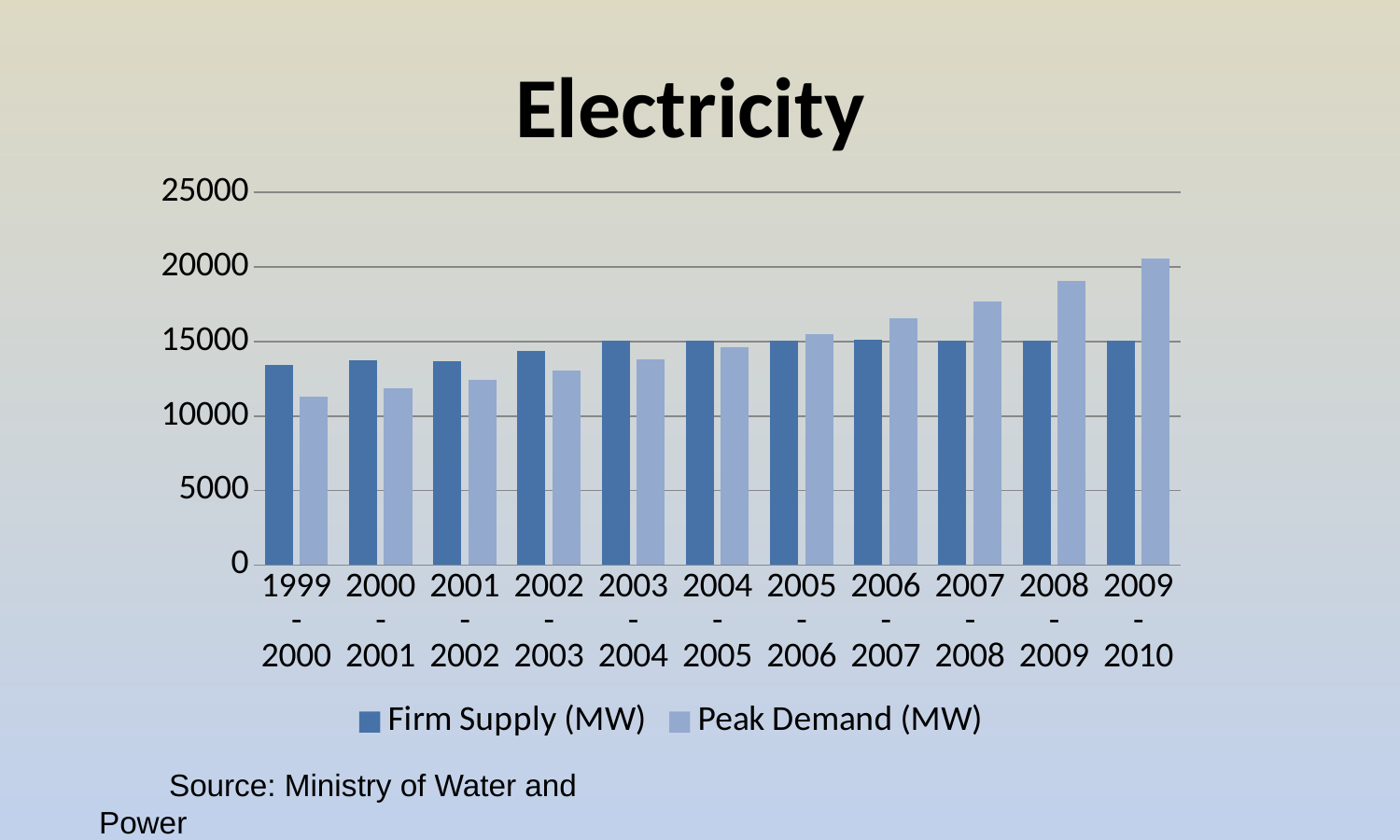
In 2009-2010, which is larger: Firm Supply (MW) or Peak Demand (MW)? Peak Demand (MW) How many series does the legend list? 2 Does Peak Demand (MW) generally rise or fall from 1999-2000 to 2009-2010? rise What is the title of the chart? Electricity Is the Peak Demand (MW) value for 2007-2008 greater or less than 15000? greater In which period is Peak Demand (MW) highest? 2009-2010 How many year periods are shown on the x axis? 11 Is the Peak Demand (MW) value for 2009-2010 greater or less than 20000? greater In which period is Peak Demand (MW) lowest? 1999-2000 What kind of chart is shown on the slide? bar chart What are the two series named in the legend? Firm Supply (MW) and Peak Demand (MW) Is the Peak Demand (MW) value for 1999-2000 greater or less than 15000? less